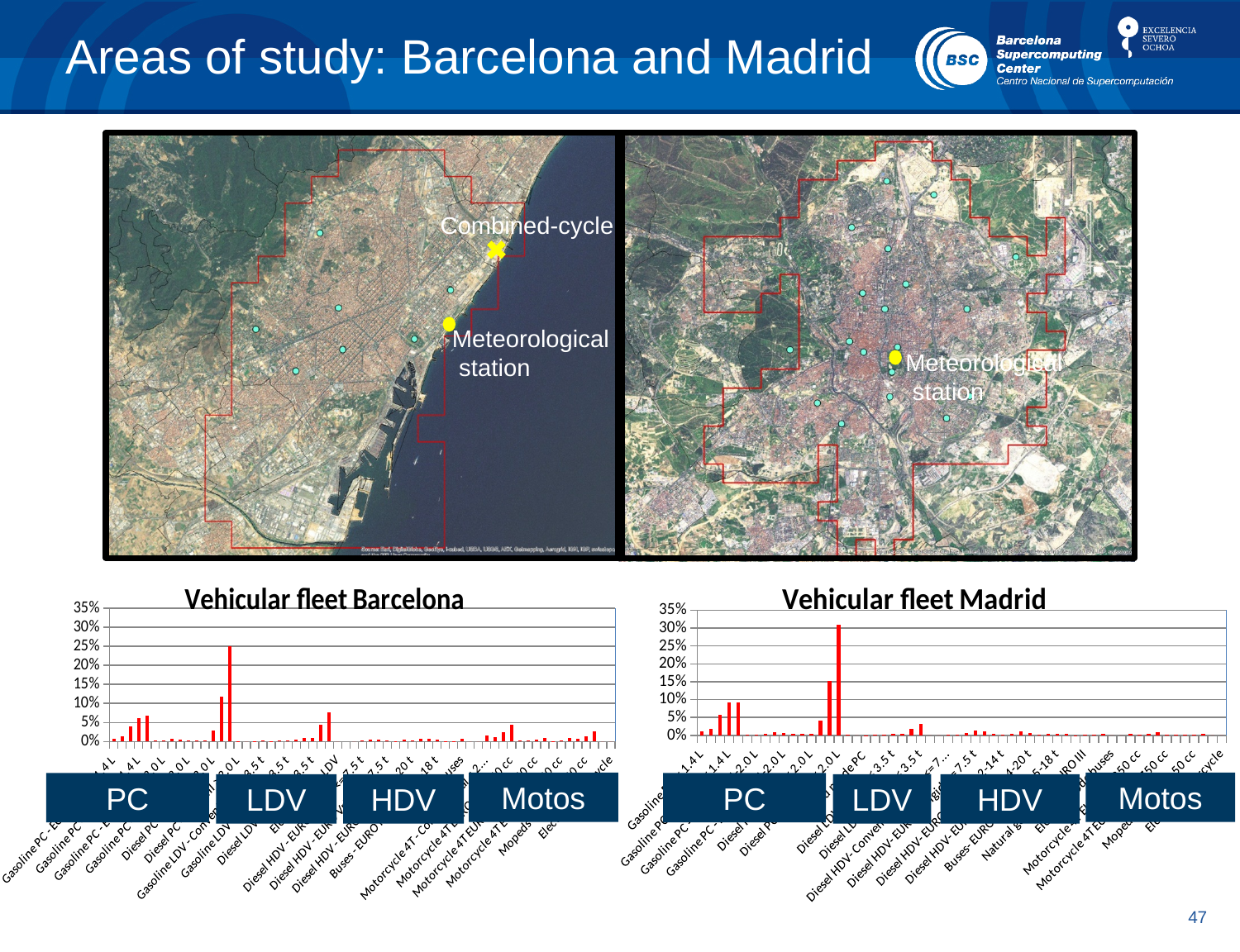
In the 'Vehicular fleet Barcelona' chart, is the tallest bar greater or less than 30%? less In the 'Vehicular fleet Madrid' chart, which vehicle group (PC, LDV, HDV or Motos) contains the tallest bar? PC In the 'Vehicular fleet Barcelona' chart, which vehicle group (PC, LDV, HDV or Motos) contains the tallest bar? PC What is the title of the chart on the bottom right of the slide? Vehicular fleet Madrid What is the title of the chart on the bottom left of the slide? Vehicular fleet Barcelona In the 'Vehicular fleet Barcelona' chart, is the tallest bar greater or less than 20%? greater Which chart has the taller maximum bar, 'Vehicular fleet Barcelona' or 'Vehicular fleet Madrid'? Vehicular fleet Madrid What is the highest value shown on the y axis of the 'Vehicular fleet Madrid' chart? 35% What kind of chart is the 'Vehicular fleet Madrid' chart? bar chart What kind of chart is the 'Vehicular fleet Barcelona' chart? bar chart In the 'Vehicular fleet Madrid' chart, is the tallest bar greater or less than 25%? greater